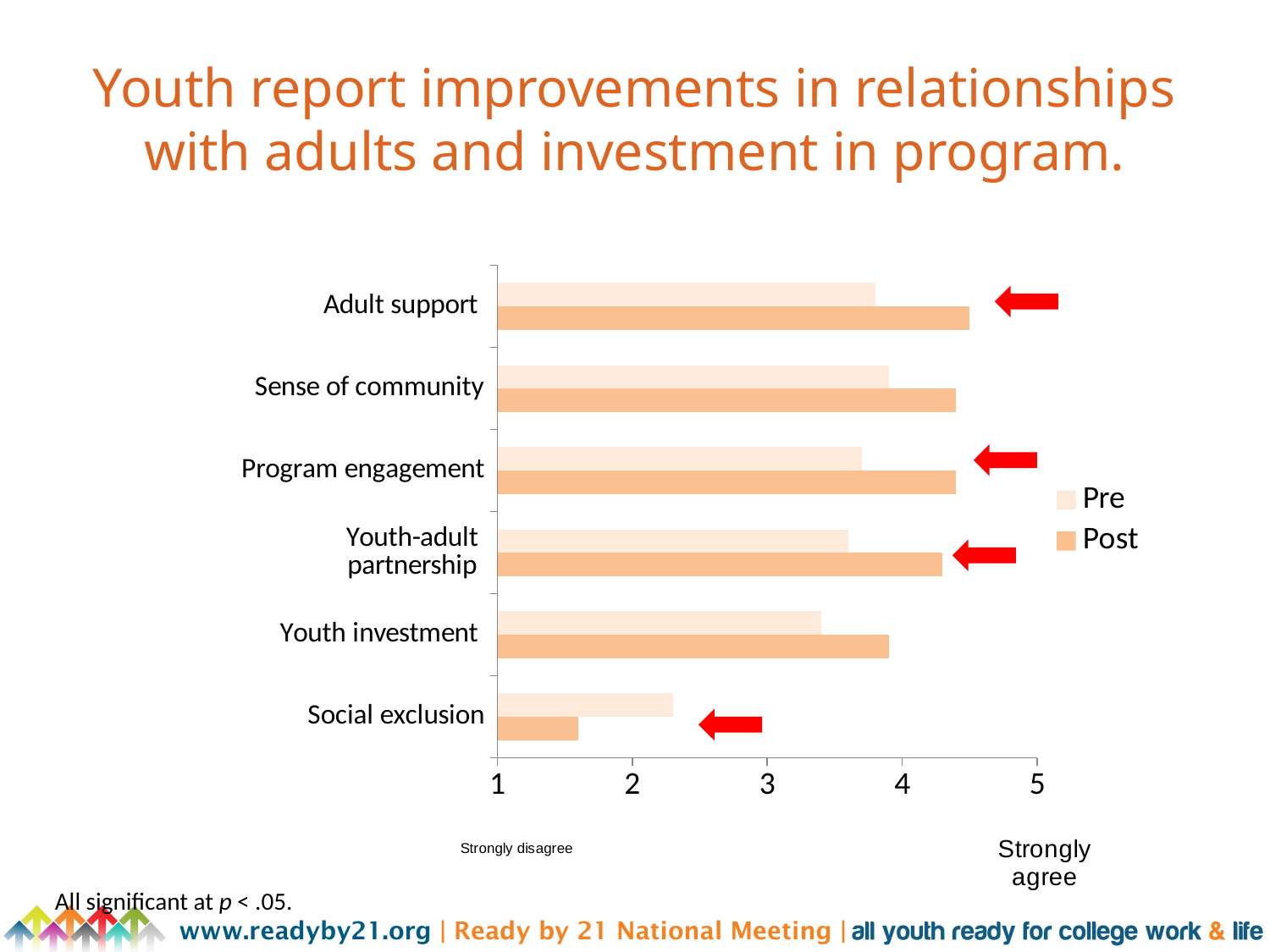
For Social exclusion, which is larger, the Pre value or the Post value? Pre What kind of chart is shown on the slide? bar chart Is the Post value for Social exclusion greater or less than 2? less How many categories are plotted on the chart? 6 Is the Pre value for Youth investment greater or less than 4? less For Adult support, which is larger, the Pre value or the Post value? Post What are the two entries in the chart's legend? Pre and Post How many series does the legend list? 2 Which category has the lowest Pre value? Social exclusion Is the Pre value for Social exclusion greater or less than 3? less Which category has the lowest Post value? Social exclusion